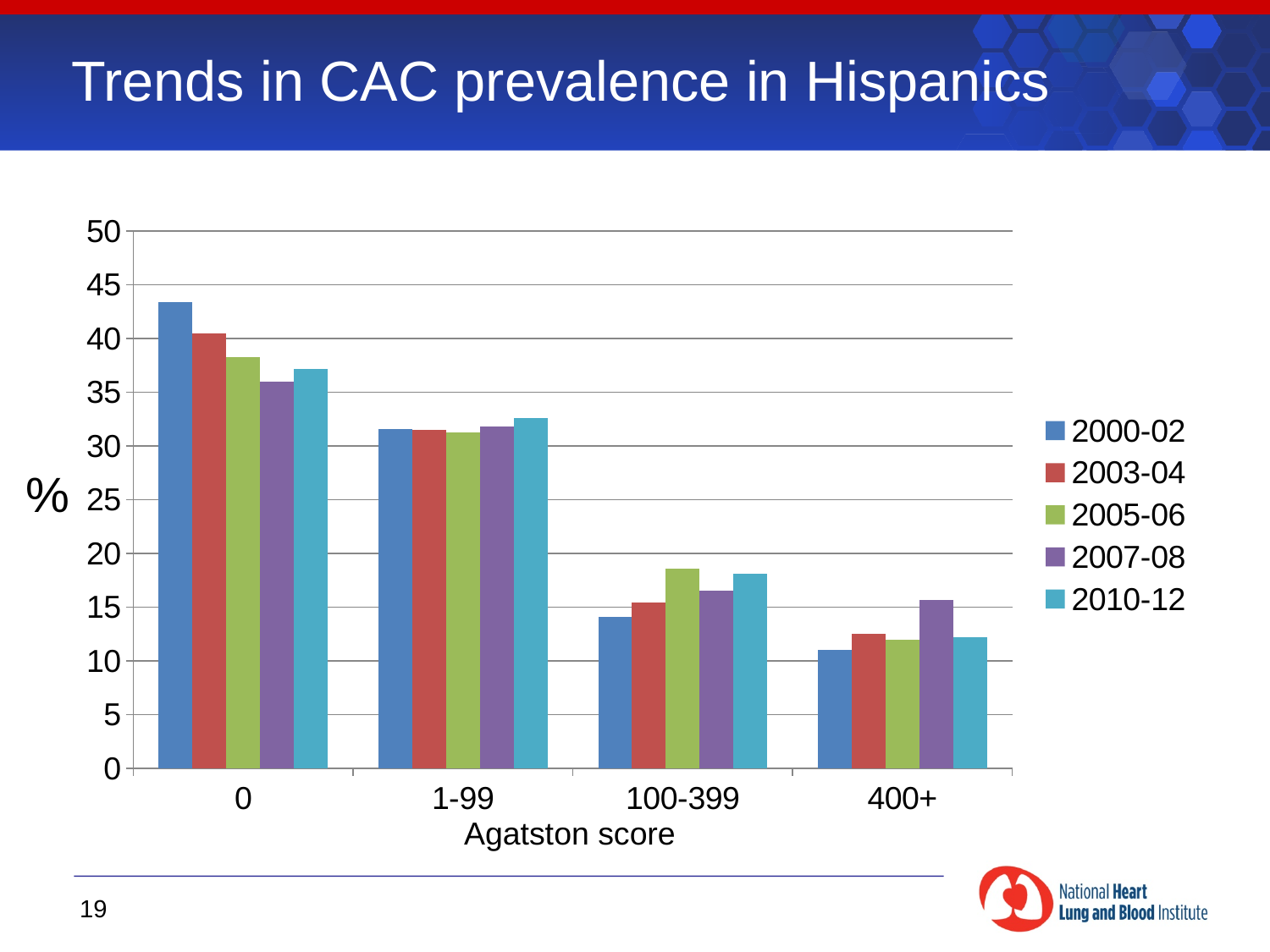
Do the values for 2000-02 rise or fall as the Agatston score categories increase along the x axis? fall Is the value for 2000-02 in the Agatston score 0 category greater or less than 40? greater In the 100-399 category, which is larger: the value for 2005-06 or the value for 2000-02? 2005-06 What kind of chart is shown on the slide? bar chart How many series does the legend list? 5 In the Agatston score 0 category, which period has the highest value? 2000-02 What is the title of the x axis? Agatston score Is the value for 2005-06 in the 100-399 category greater or less than 15? greater Which is larger for 2000-02: the value in the 0 category or the value in the 400+ category? 0 Is the value for 2010-12 in the 1-99 category greater or less than 30? greater How many Agatston score categories are shown on the x axis? 4 In the Agatston score 400+ category, which period has the highest value? 2007-08